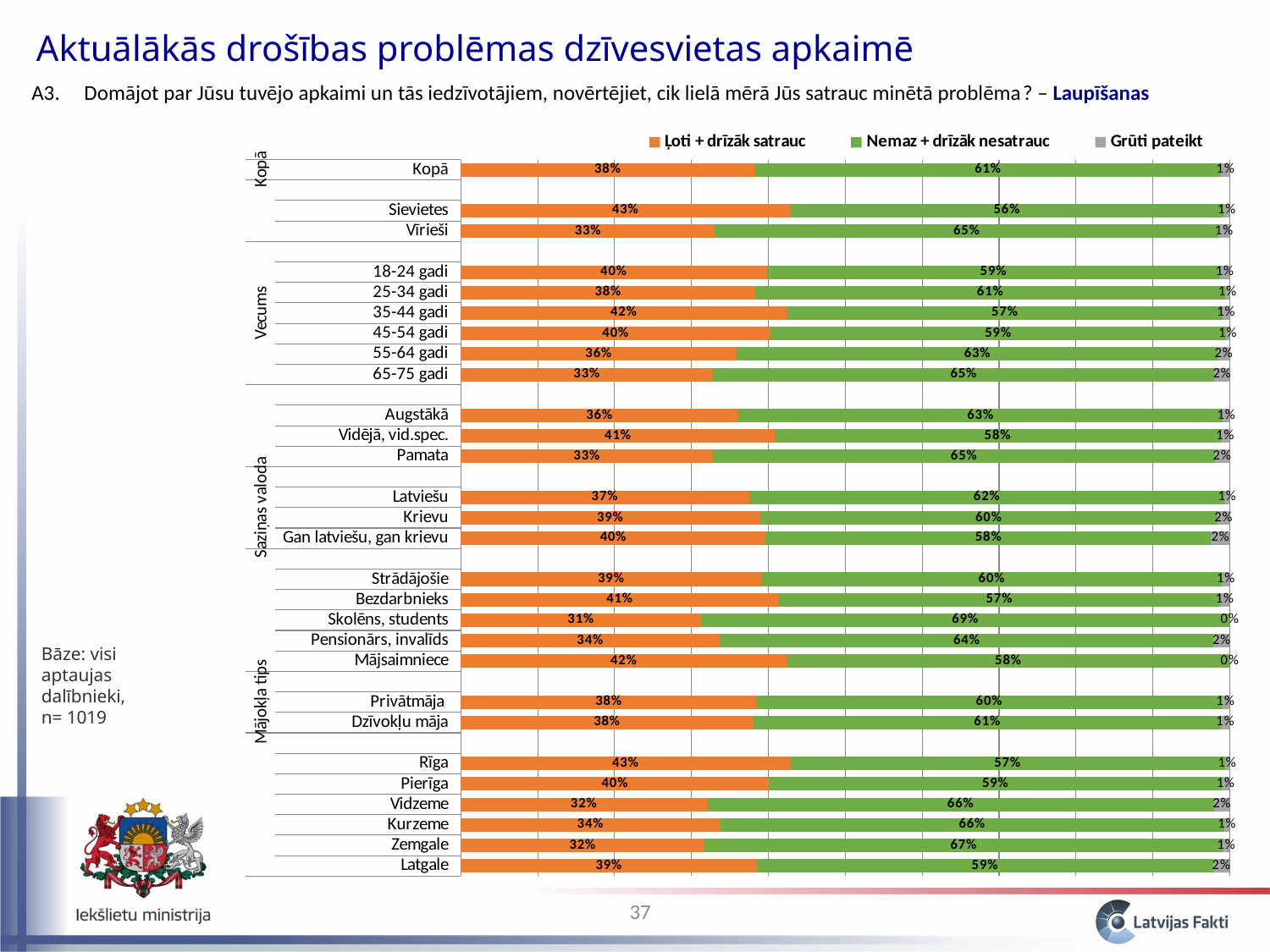
Which colour represents the "Nemaz + drīzāk nesatrauc" series? Green How many series does the legend list? 3 Which has a higher "Ļoti + drīzāk satrauc" value, "Rīga" or "Vidzeme"? Rīga What is the difference in percentage points between the "Ļoti + drīzāk satrauc" values for "Sievietes" and "Vīrieši"? 10 What is the "Nemaz + drīzāk nesatrauc" value for "Skolēns, students"? 69% Which category has the lowest "Ļoti + drīzāk satrauc" value? Skolēns, students What is the total of the stacked bar for "Kopā"? 100% Which category has the lowest "Nemaz + drīzāk nesatrauc" value? Sievietes Which has a higher "Nemaz + drīzāk nesatrauc" value, "Zemgale" or "Pierīga"? Zemgale What type of chart is shown on the slide? Stacked bar chart What is the "Grūti pateikt" value for "Latgale"? 2% What percentage of respondents in the "Kopā" row fall into the "Ļoti + drīzāk satrauc" category? 38%